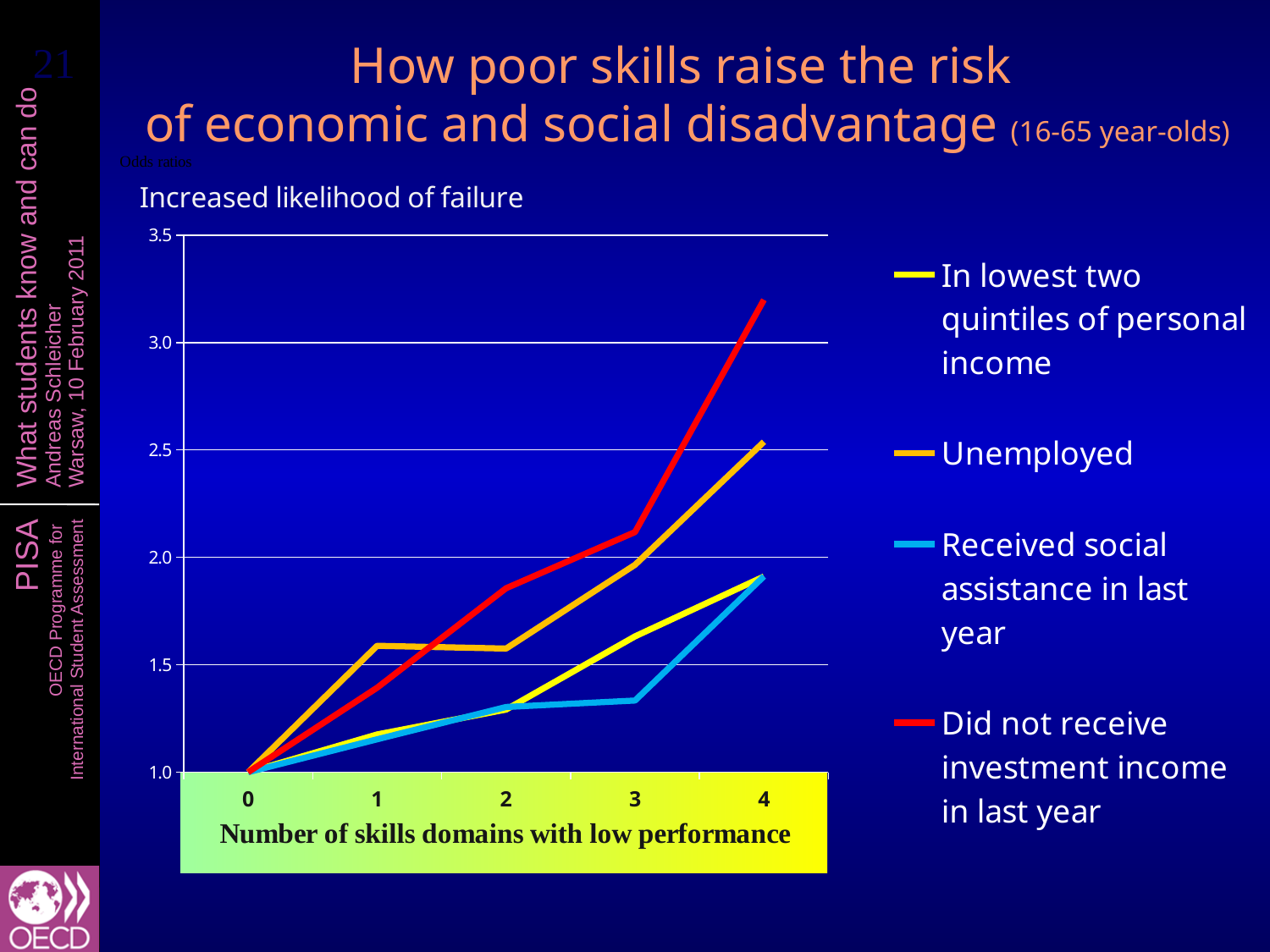
Do the values for 'Unemployed' rise or fall as the number of skills domains with low performance increases from 0 to 4? rise Is the value for 'In lowest two quintiles of personal income' at 4 skills domains greater or less than 2.0? less What is the label of the x axis? Number of skills domains with low performance Which series has the highest value at 1 skills domain with low performance? Unemployed Which series has the highest value at 4 skills domains with low performance? Did not receive investment income in last year Is the value for 'Did not receive investment income in last year' at 4 skills domains greater or less than 3.0? greater What kind of chart is shown on the slide? line chart How many points on the x axis (number of skills domains with low performance) are plotted for each series? 5 Which series has the lowest value at 3 skills domains with low performance? Received social assistance in last year Is the value for 'Unemployed' at 4 skills domains greater or less than 3.0? less How many series does the legend list? 4